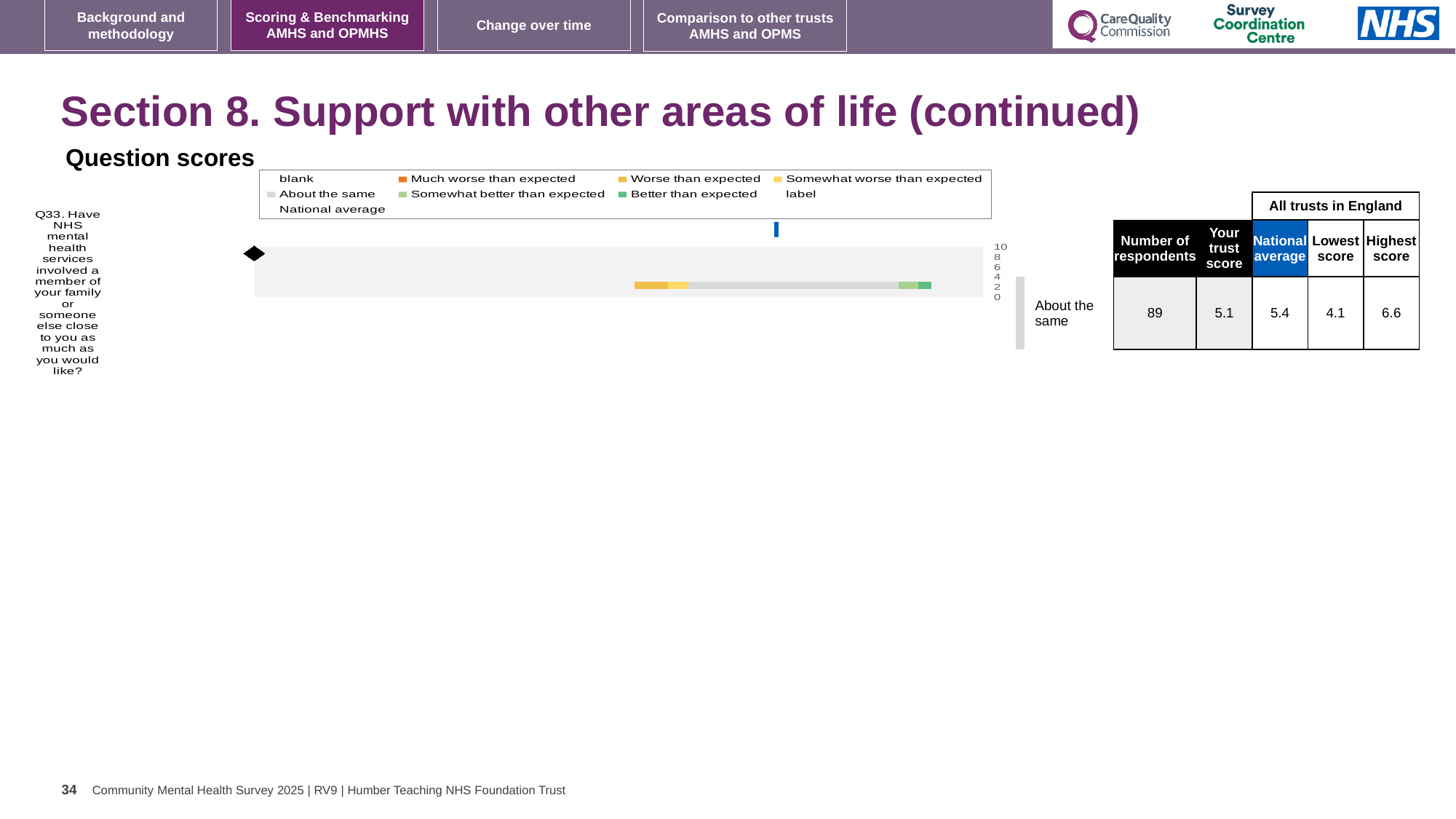
What kind of chart is shown under 'Question scores'? bar chart What is the highest score among all trusts in England for Q33? 6.6 For Q33, what is the difference between the highest score and the lowest score among all trusts in England? 2.5 What is the national average for Q33 shown in the table beside the chart? 5.4 How many entries does the chart legend list? 9 What is the lowest score among all trusts in England for Q33? 4.1 How many survey questions are plotted in the chart? 1 Which question is plotted in the chart? Q33. Have NHS mental health services involved a member of your family or someone else close to you as much as you would like? What is the trust score for Q33 shown in the table beside the chart? 5.1 According to the table beside the chart, how many respondents answered Q33? 89 What benchmark category is shown for Q33 next to the chart? About the same For Q33, which is larger: the trust score or the national average? National average